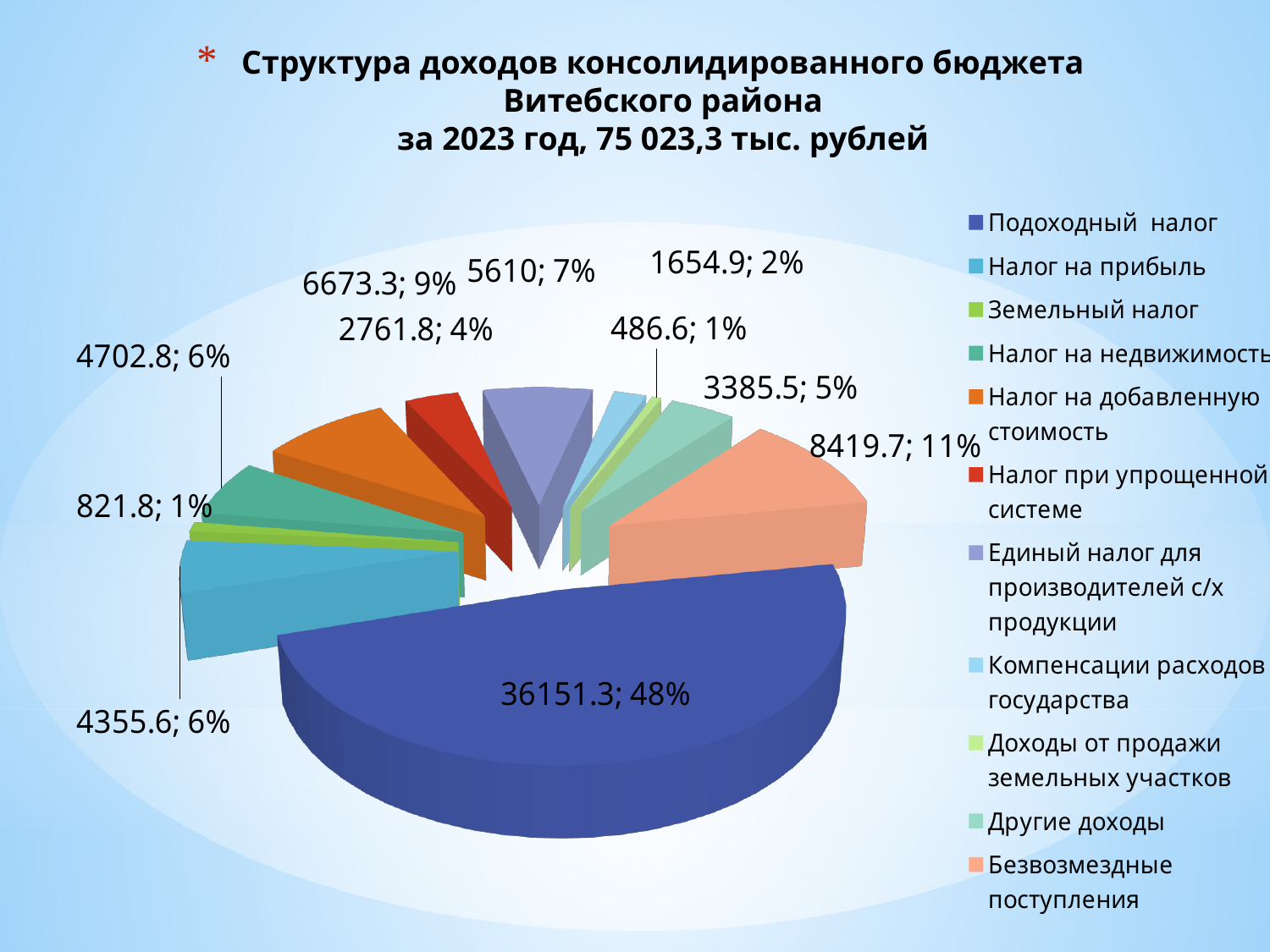
Which is larger, the value for Налог на недвижимость or the value for Налог на прибыль? Налог на недвижимость What value is shown for Единый налог для производителей с/х продукции? 5610 What share of the pie does Налог на добавленную стоимость take? 9% What kind of chart is shown on the slide? pie chart Which category has the largest slice of the pie? Подоходный налог Which category has the smallest value in the pie chart? Доходы от продажи земельных участков What share of the pie does Подоходный налог take? 48% What value is shown for Безвозмездные поступления? 8419.7 What total amount is stated in the chart title for 2023? 75 023,3 тыс. рублей What is the difference between the values for Безвозмездные поступления and Налог на добавленную стоимость? 1746.4 What value is shown for Подоходный налог? 36151.3 How many categories does the legend of the pie chart list? 11